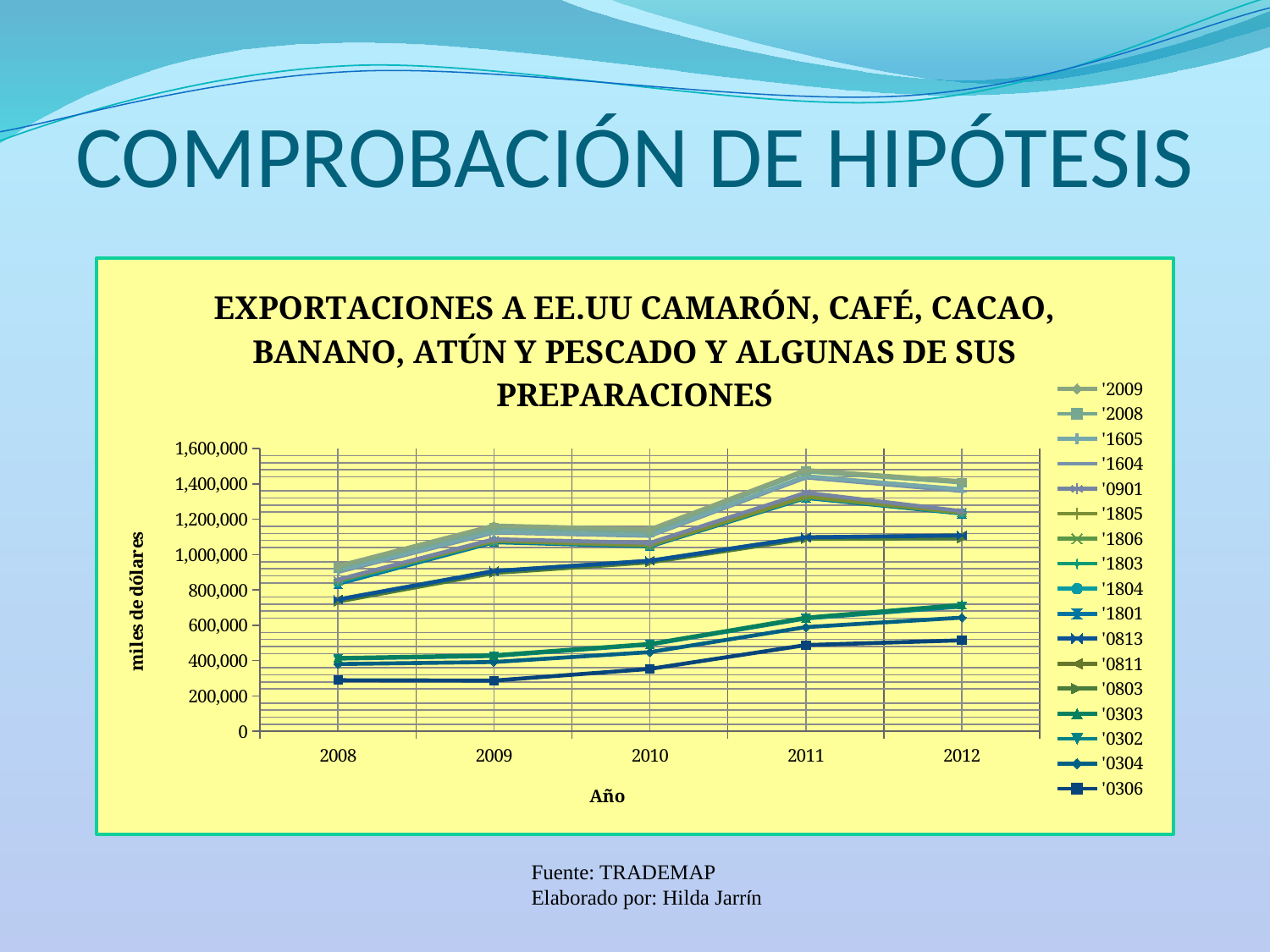
Is the highest value plotted for 2011 greater or less than 1,400,000? greater What is the label of the x axis of the chart? Año In which year does the chart reach its highest plotted value? 2011 What is the first year shown on the x axis of the chart? 2008 How many series does the chart's legend list? 17 What is the last year shown on the x axis of the chart? 2012 What is the label of the y axis of the chart? miles de dólares What kind of chart is shown on the slide? line chart Between 2008 and 2011, do the plotted values generally rise or fall? rise Is the highest value plotted for 2008 greater or less than 1,000,000? less Is the lowest value plotted for 2008 greater or less than 400,000? less How many years are plotted along the x axis of the chart? 5